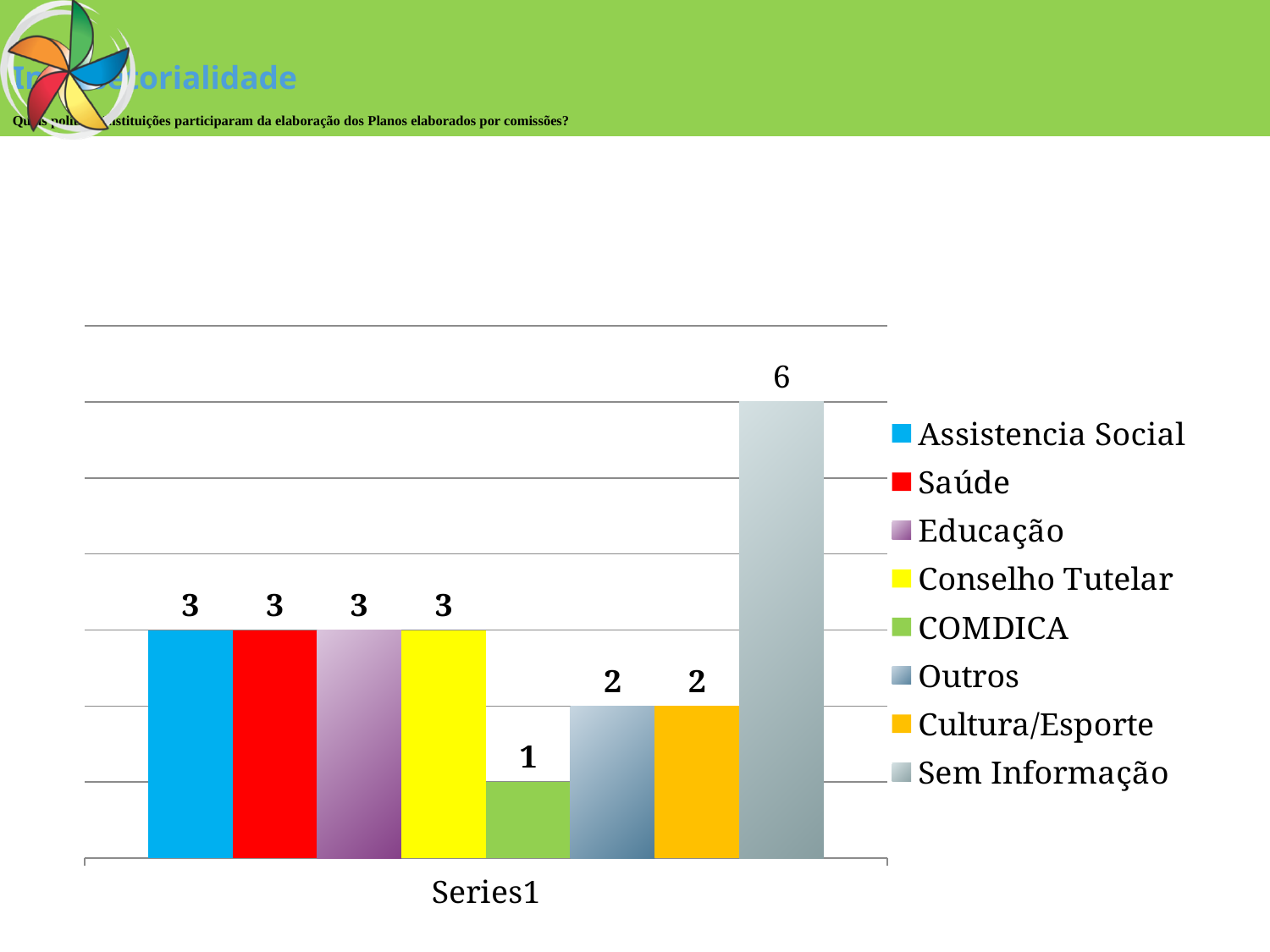
What is the value for COMDICA? 1 What is the difference between the values for Outros and COMDICA? 1 What is the value for Sem Informação? 6 Which category has the lowest value? COMDICA What label appears on the x axis below the bars? Series1 What is the difference between the values for Sem Informação and Saúde? 3 Which category has the highest value? Sem Informação How many entries does the legend list? 8 What kind of chart is shown on the slide? Bar chart What is the value for Cultura/Esporte? 2 What is the value for Conselho Tutelar? 3 Which is larger, the value for Educação or the value for Cultura/Esporte? Educação